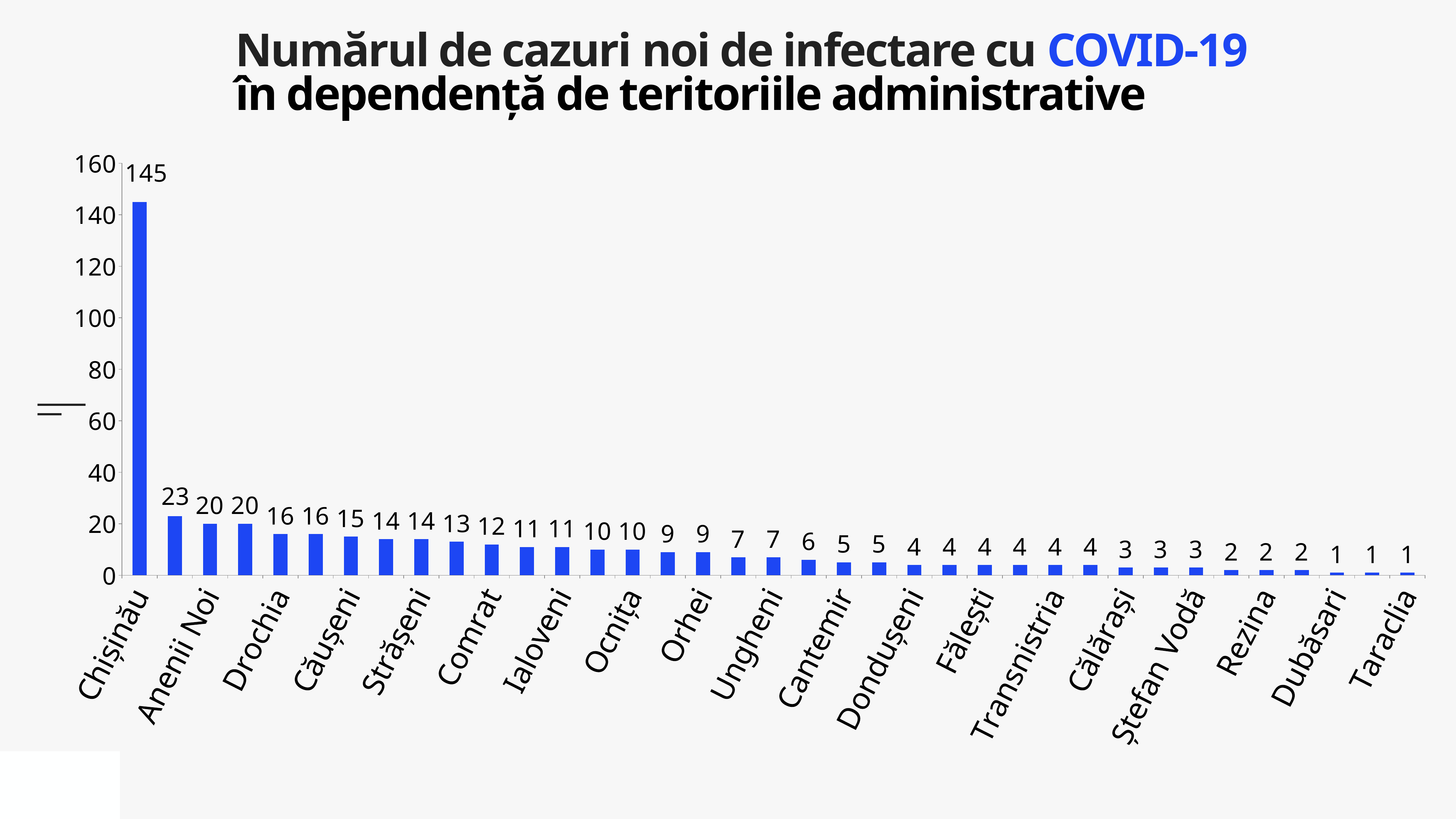
Is the value for Taraclia greater or less than 20? less Do the values rise or fall from left to right along the x axis? fall Which is larger, the value for Chișinău or the value for Orhei? Chișinău Which territory has the highest number of new cases? Chișinău What is the highest tick value on the vertical axis? 160 What kind of chart is shown on the slide? bar chart What is the value for Chișinău? 145 What is the second-highest value shown on the chart? 23 What is the lowest value shown on the chart? 1 What colour are the bars in the chart? blue Is the value for Chișinău greater or less than 140? greater